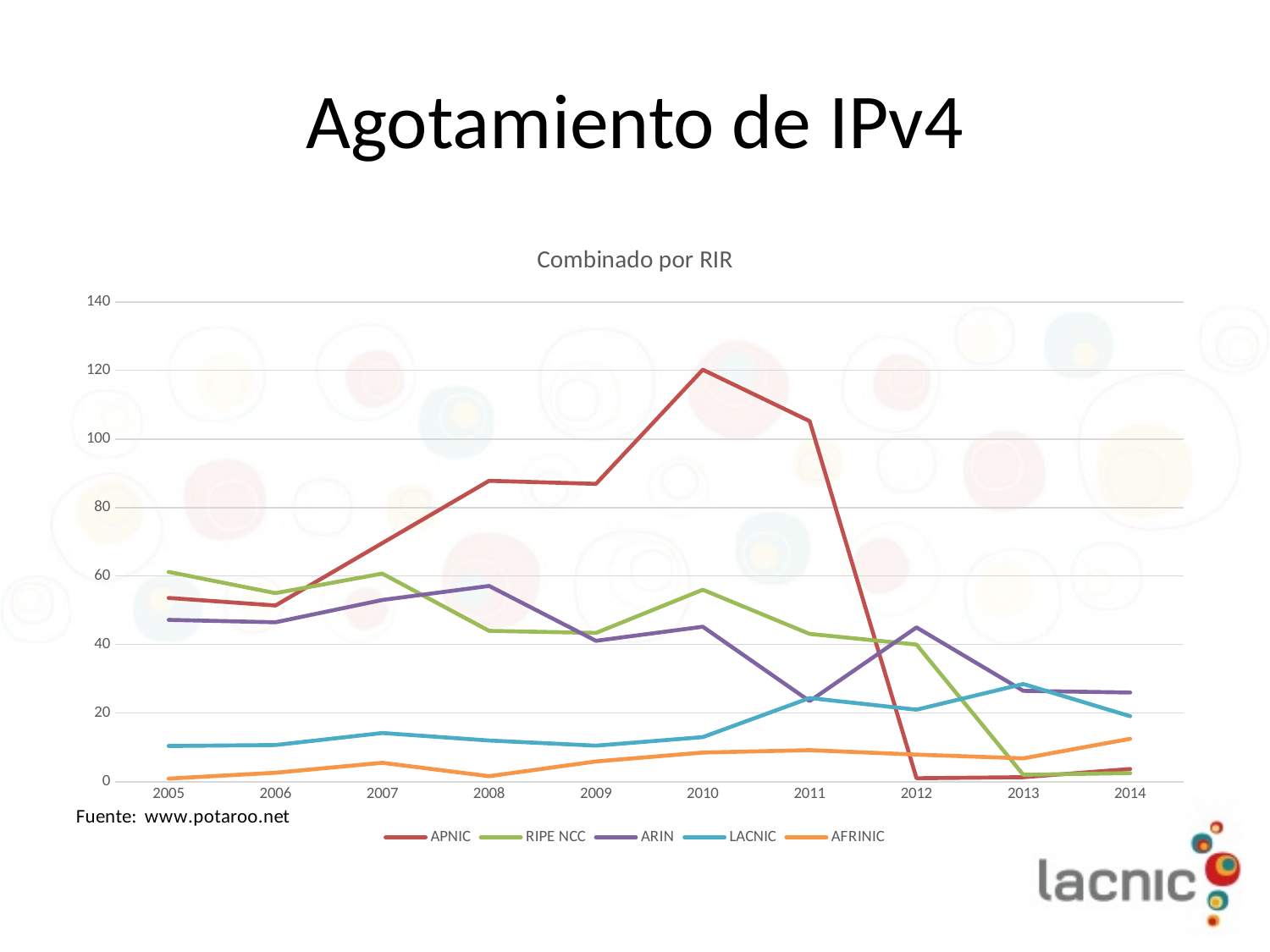
In 2013, which is larger: the value for LACNIC or the value for RIPE NCC? LACNIC Is the value for APNIC in 2010 greater or less than 100? greater What is the title of the chart? Combinado por RIR Is the value for APNIC in 2012 greater or less than 20? less Is the value for AFRINIC in 2014 greater or less than 20? less Which series has the lowest value in 2005? AFRINIC How many years are shown along the x axis? 10 Which series has the highest value in 2010? APNIC What kind of chart is shown on the slide? line chart Which series is drawn in red? APNIC How many series does the legend list? 5